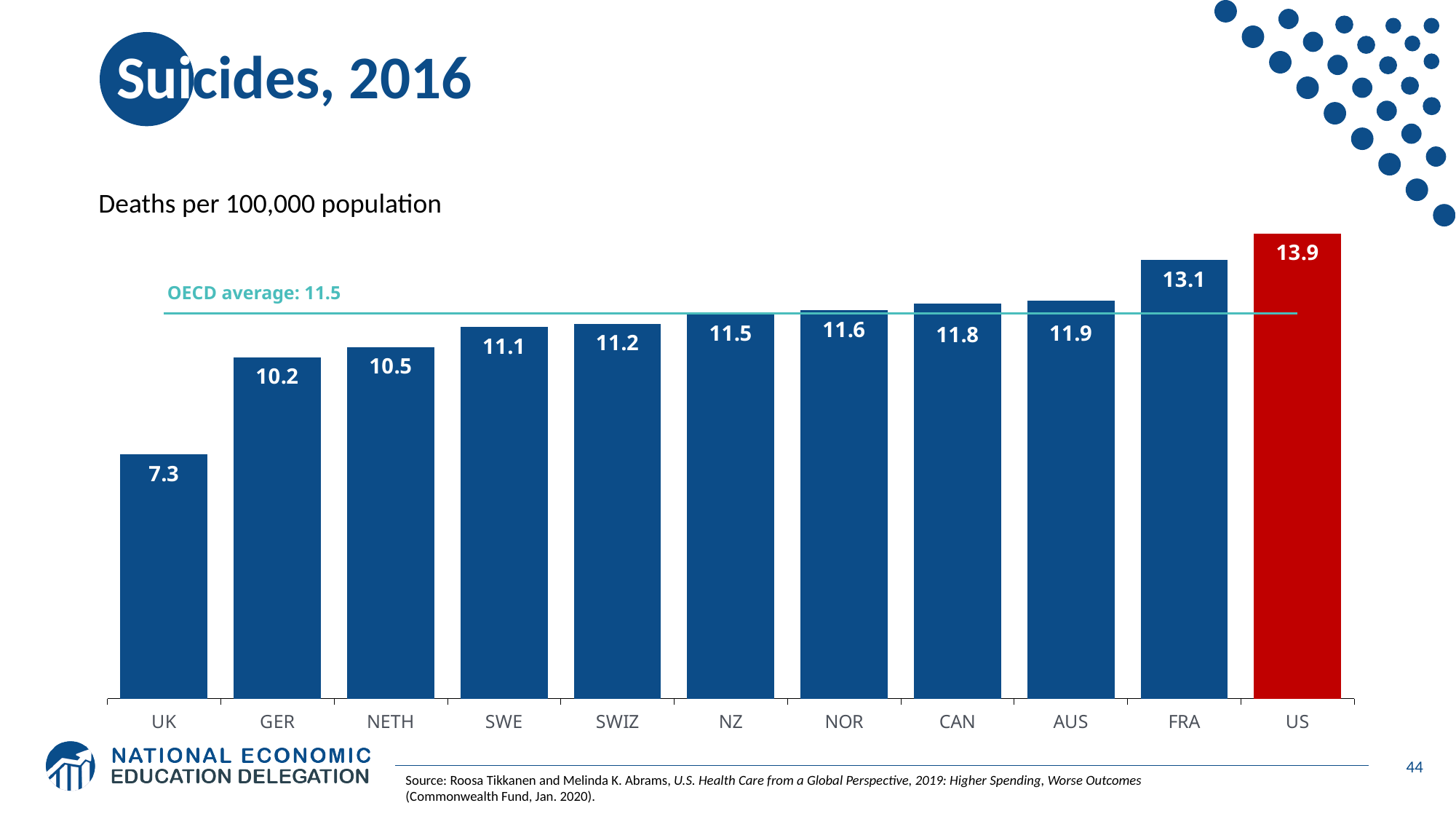
How many countries are shown on the chart? 11 What kind of chart is shown on the slide? Bar chart Which country has the lowest suicide rate on the chart? UK What is the difference between the US value and the FRA value? 0.8 What is the value shown for NOR? 11.6 Which country has the highest suicide rate on the chart? US Do the values rise or fall moving from left to right across the chart? Rise What is the value shown for GER? 10.2 What is the suicide rate (deaths per 100,000 population) for the US? 13.9 Which has a higher value, NETH or SWE? SWE What OECD average value is marked by the horizontal line on the chart? 11.5 What is the difference between the UK value and the GER value? 2.9